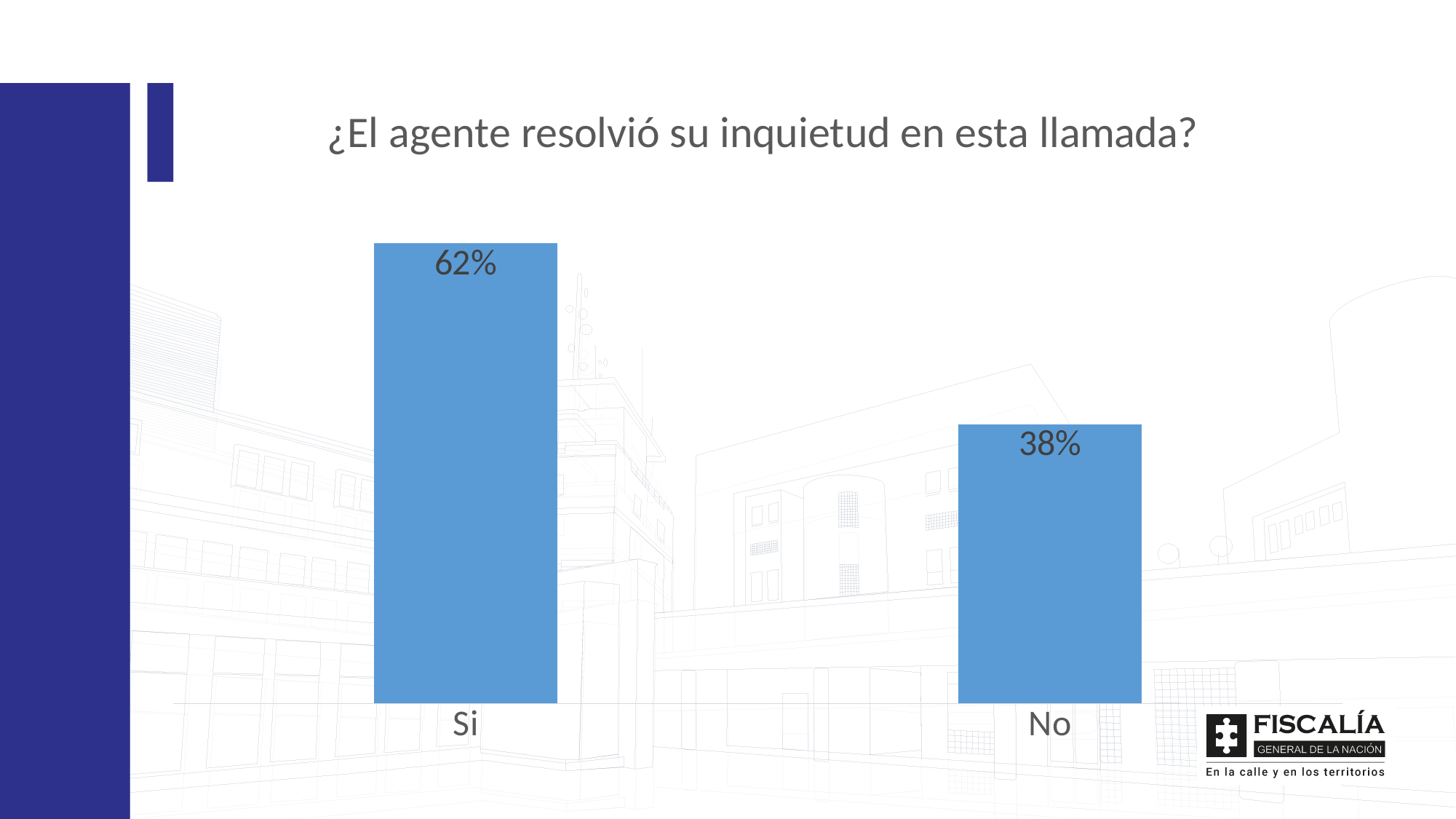
What is the total of the values for "Si" and "No"? 100% Which category has the highest value? Si How many categories are shown in the chart? 2 What colour are the bars in the chart? Blue What is the value for "Si"? 62% Which category has the lowest value? No What kind of chart is shown on the slide? Bar chart Which is larger, the value for "Si" or the value for "No"? Si What is the value for "No"? 38% What is the difference between the values for "Si" and "No"? 24% What is the title of the chart? ¿El agente resolvió su inquietud en esta llamada?